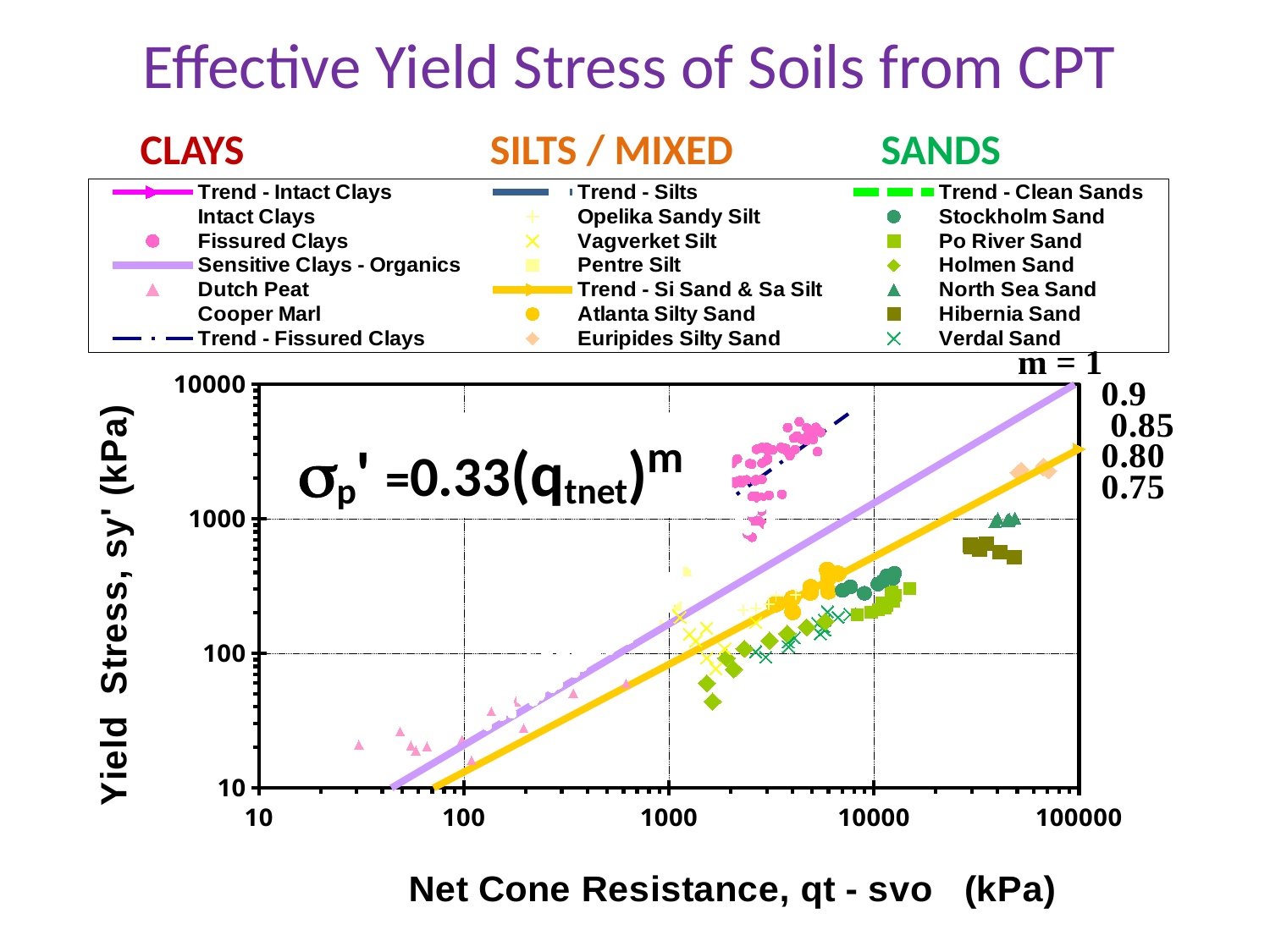
Is the yield stress of the Dutch Peat points greater or less than 100 kPa? less Which soil group's points have the lowest yield stress values on the chart? Dutch Peat What is the label of the x axis? Net Cone Resistance, qt - svo (kPa) Which has higher yield stress values, the Fissured Clays points or the Hibernia Sand points? Fissured Clays Is the net cone resistance of the Hibernia Sand points greater or less than 10000 kPa? greater How many entries does the legend list in total? 21 Is the yield stress of the Euripides Silty Sand points greater or less than 1000 kPa? greater What is the label of the y axis? Yield Stress, sy' (kPa) What kind of chart is shown on the slide? Scatter chart Do the trend lines rise or fall as net cone resistance increases? Rise